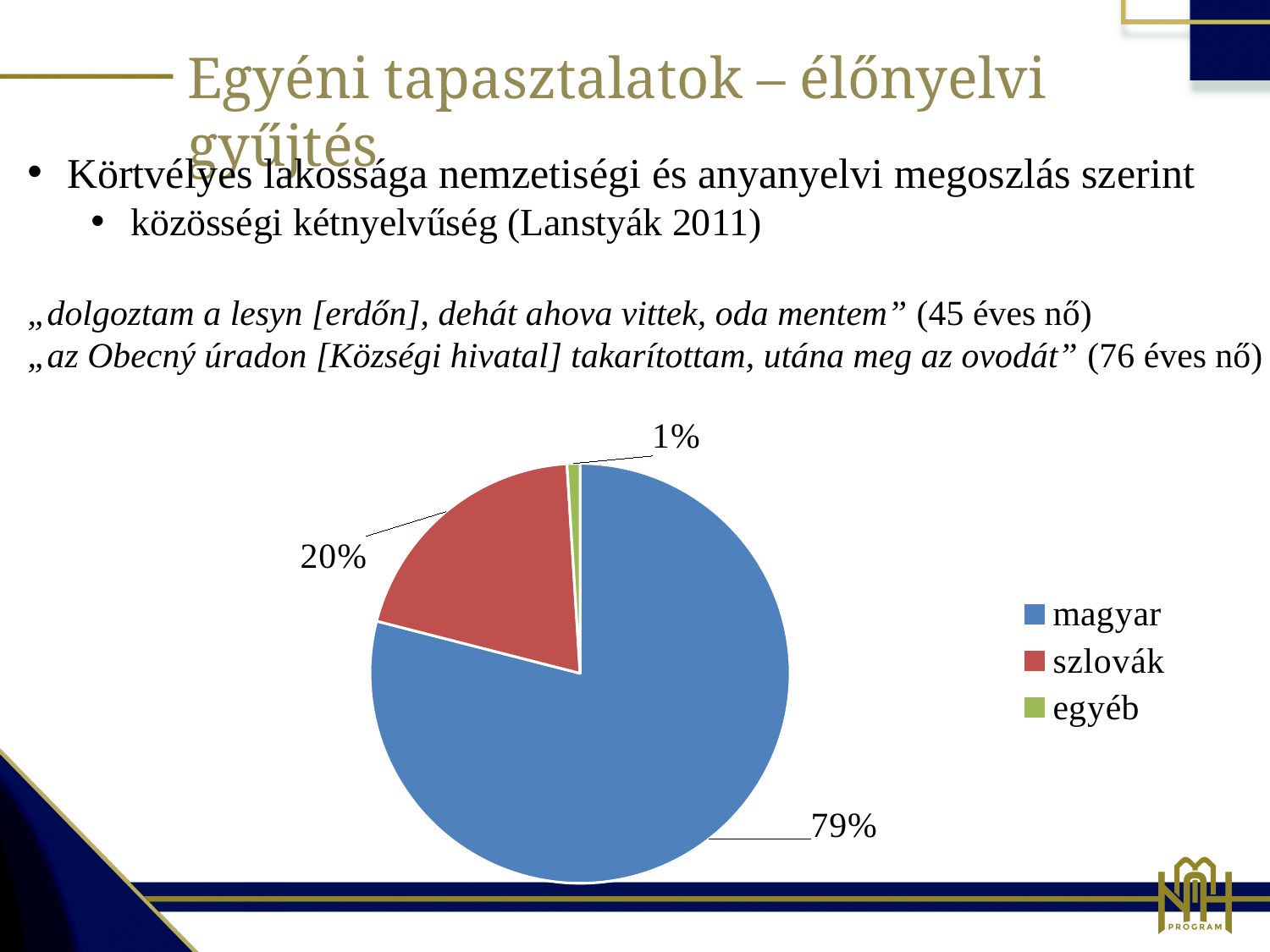
What colour is the szlovák slice in the pie chart? red Which is larger, the szlovák slice or the egyéb slice? szlovák Which category has the largest slice of the pie? magyar Which category has the smallest slice of the pie? egyéb What share of the pie does the magyar slice represent? 79% How many categories does the pie chart have? 3 How many entries does the legend list? 3 What share of the pie does the egyéb slice represent? 1% What kind of chart is shown on the slide? pie chart What share of the pie does the szlovák slice represent? 20% What is the difference in percentage points between the magyar and szlovák slices? 59 What is the difference in percentage points between the szlovák and egyéb slices? 19